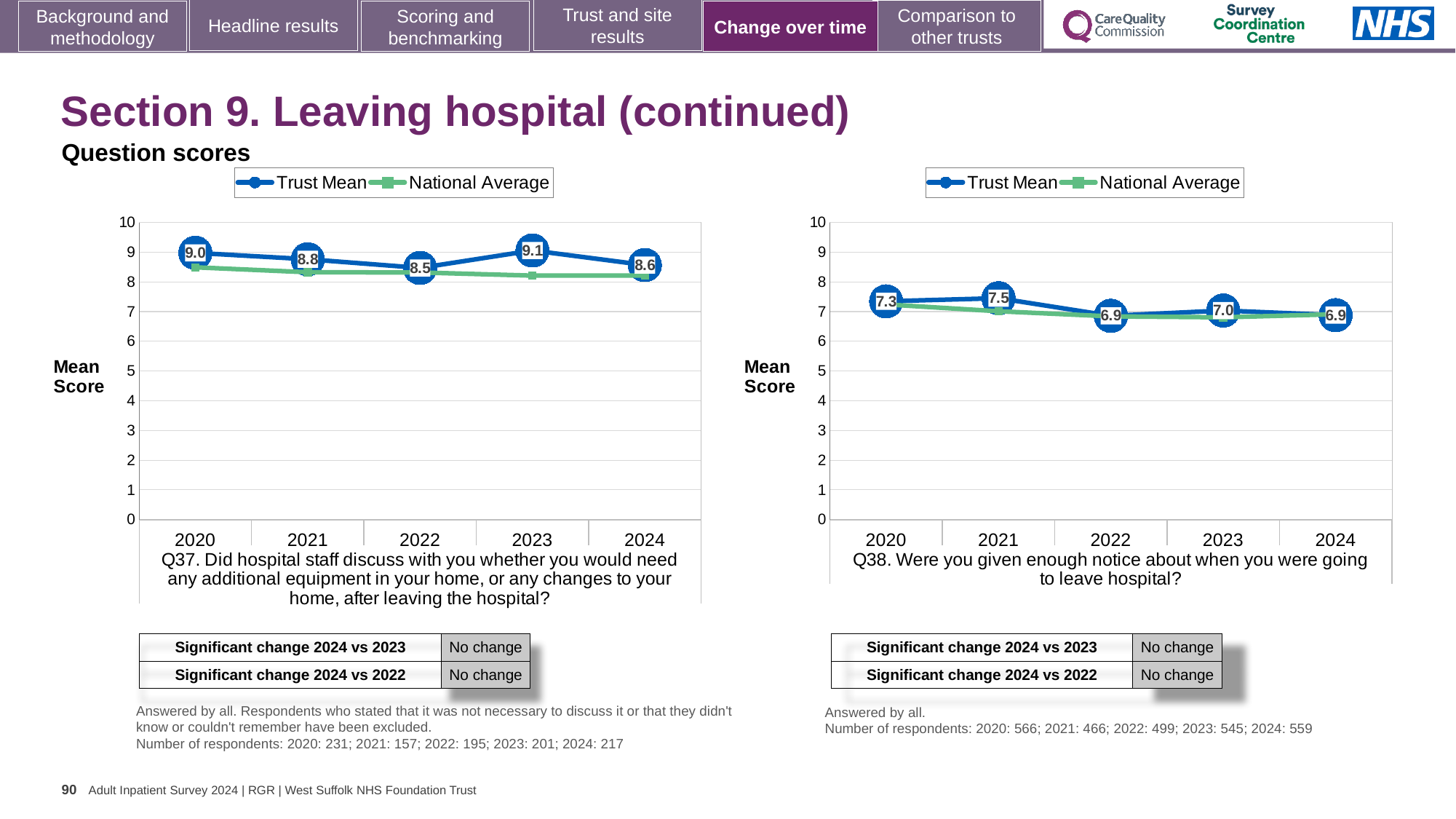
On the Q37 chart (left), which year has the highest Trust Mean score? 2023 On the Q38 chart (right), which year has the highest Trust Mean score? 2021 On the Q38 chart (right), is the Trust Mean score for 2021 larger than the Trust Mean score for 2020? Yes On the Q38 chart (right), what is the Trust Mean score for 2021? 7.5 On the Q37 chart (left), what is the Trust Mean score for 2022? 8.5 On the Q37 chart (left), which year has the lowest Trust Mean score? 2022 On the Q38 chart (right), is the National Average value for 2024 greater or less than 8? less On the Q38 chart (right), what is the Trust Mean score for 2024? 6.9 How many years are plotted on the x axis of the Q37 chart (left)? 5 How many series does the legend of the Q38 chart (right) list? 2 On the Q37 chart (left), what is the difference between the Trust Mean scores for 2020 and 2024? 0.4 On the Q37 chart (left), what is the Trust Mean score for 2023? 9.1